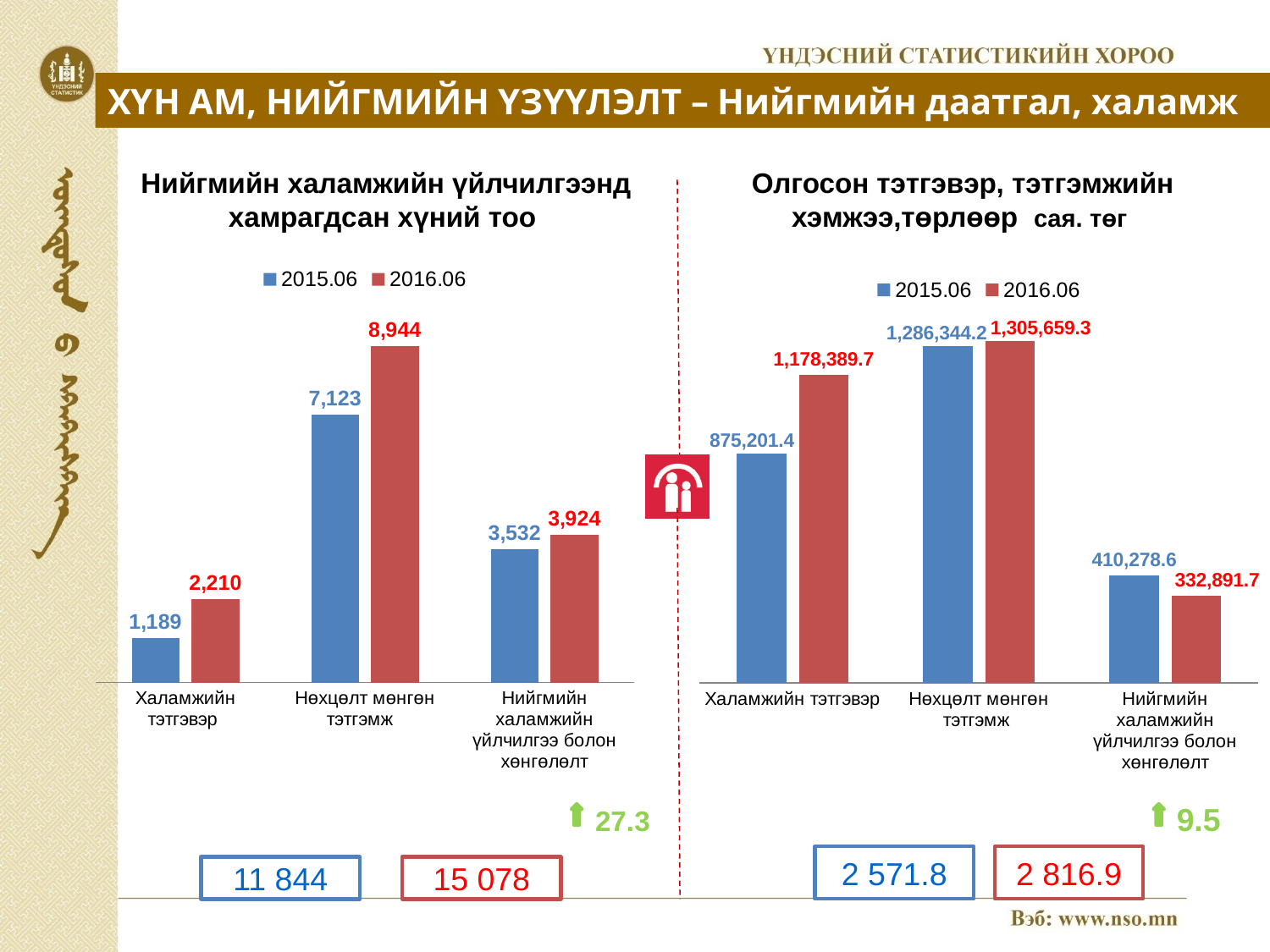
In the right chart, what is the 2015.06 value for Нийгмийн халамжийн үйлчилгээ болон хөнгөлөлт? 410,278.6 In the left chart, which category has the highest 2016.06 value? Нөхцөлт мөнгөн тэтгэмж In the left chart (Нийгмийн халамжийн үйлчилгээнд хамрагдсан хүний тоо), what is the 2016.06 value for Нөхцөлт мөнгөн тэтгэмж? 8,944 In the right chart, which category has the highest 2016.06 value? Нөхцөлт мөнгөн тэтгэмж In the right chart, which is larger for Нийгмийн халамжийн үйлчилгээ болон хөнгөлөлт: the 2015.06 value or the 2016.06 value? 2015.06 In the left chart, how many series does the legend list? 2 In the left chart, what is the difference between the 2016.06 and 2015.06 values for Халамжийн тэтгэвэр? 1,021 In the right chart (Олгосон тэтгэвэр, тэтгэмжийн хэмжээ, төрлөөр), what is the 2016.06 value for Халамжийн тэтгэвэр? 1,178,389.7 In the left chart, which category has the lowest 2015.06 value? Халамжийн тэтгэвэр What type of chart is the left chart? Bar chart How many categories are shown on the x axis of the right chart? 3 In the left chart, what is the 2015.06 value for Халамжийн тэтгэвэр? 1,189